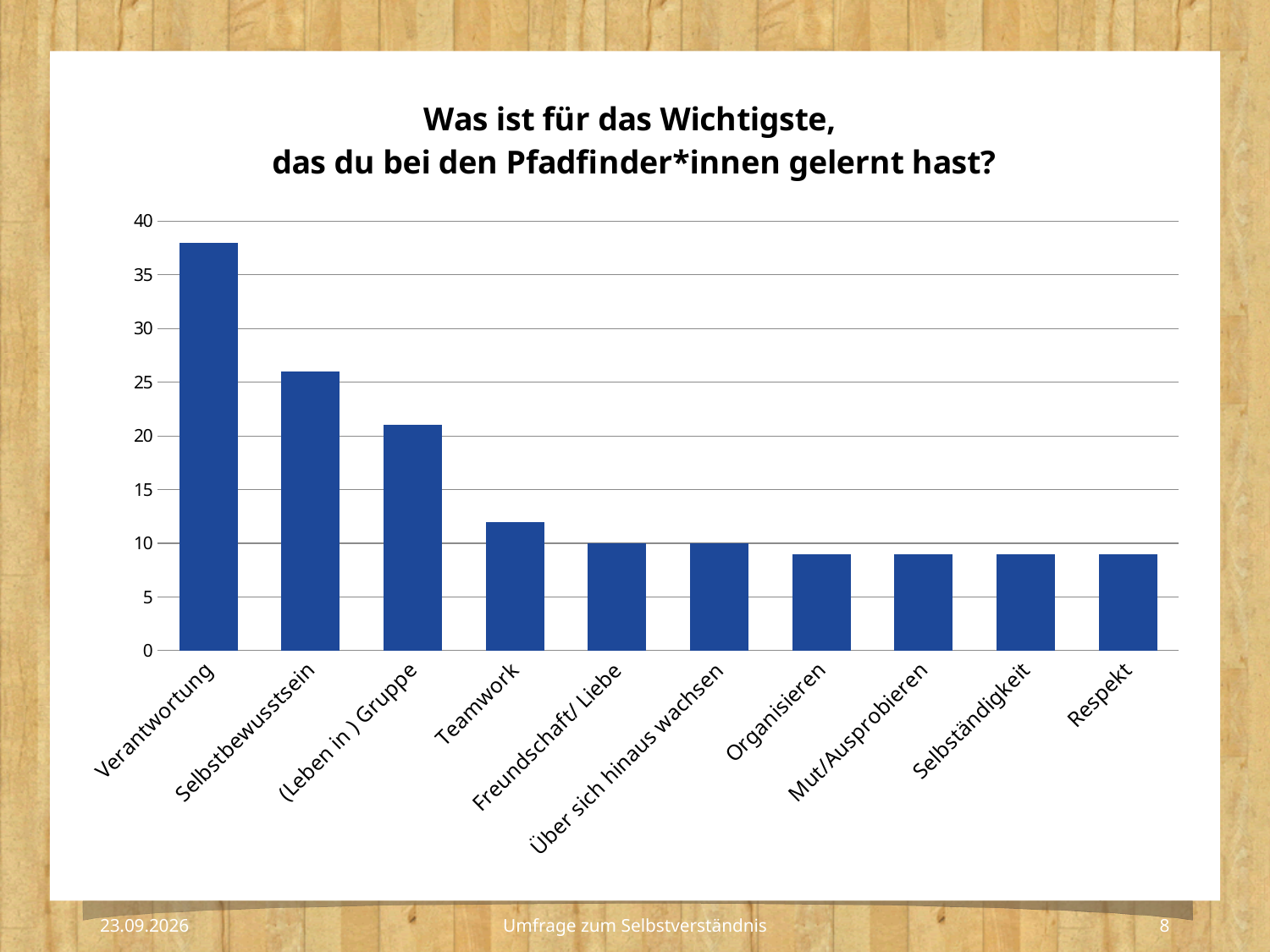
What is the value for Freundschaft/ Liebe? 10 What is the value for Über sich hinaus wachsen? 10 Is the value for (Leben in ) Gruppe greater or less than 25? less What kind of chart is shown on the slide? bar chart Is the value for Teamwork greater or less than 15? less Is the value for Selbstbewusstsein greater or less than 25? greater What is the title of the chart? Was ist für das Wichtigste, das du bei den Pfadfinder*innen gelernt hast? Which is larger, the value for Selbstbewusstsein or the value for Teamwork? Selbstbewusstsein Which category has the highest value in the chart? Verantwortung How many categories are shown on the x axis of the chart? 10